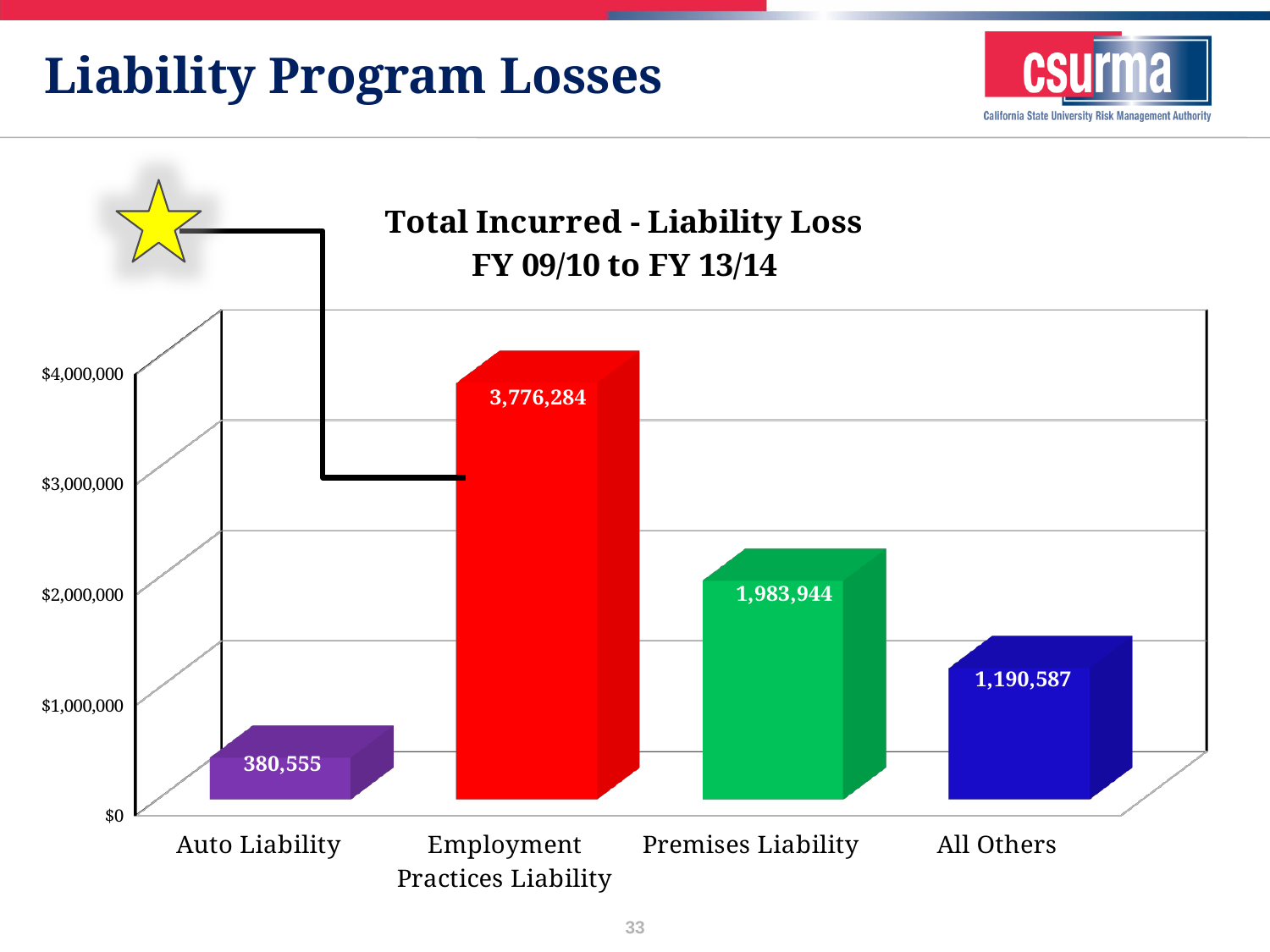
What type of chart is shown on the slide? Bar chart What is the difference between the values for Employment Practices Liability and Premises Liability? 1,792,340 Is the value for Auto Liability greater or less than $1,000,000? less What is the difference between the values for All Others and Auto Liability? 810,032 How many categories are shown in the chart? 4 Which category has the highest total incurred liability loss? Employment Practices Liability Which category has the lowest total incurred liability loss? Auto Liability What is the value for Premises Liability? 1,983,944 What is the value for Employment Practices Liability? 3,776,284 Which is larger, the value for Premises Liability or the value for All Others? Premises Liability What is the value for All Others? 1,190,587 What is the value for Auto Liability? 380,555